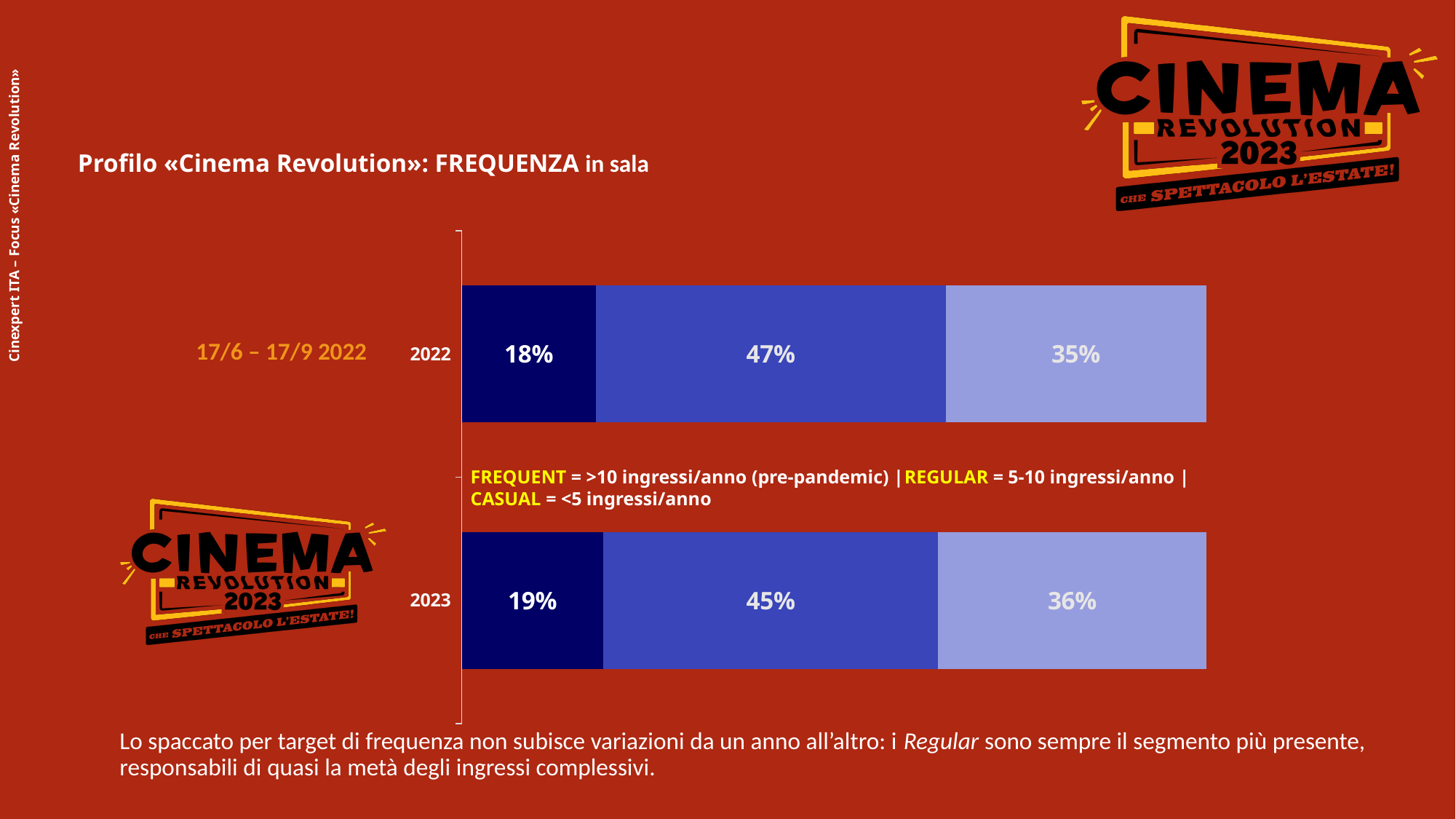
According to the legend text, how is the Regular segment defined? 5-10 ingressi/anno What kind of chart is shown on the slide? Stacked bar chart What is the difference between the Regular share in 2022 and in 2023? 2 percentage points Is the Casual share larger in 2022 or in 2023? 2023 What is the Casual share for 2022? 35% What is the Frequent share for 2023? 19% How many years (bars) are shown in the chart? 2 What is the Frequent share for 2022? 18% Which frequency segment is the smallest in 2023? Frequent Which frequency segment is the largest in 2022? Regular How many frequency segments make up each bar? 3 What is the Regular share for 2023? 45%